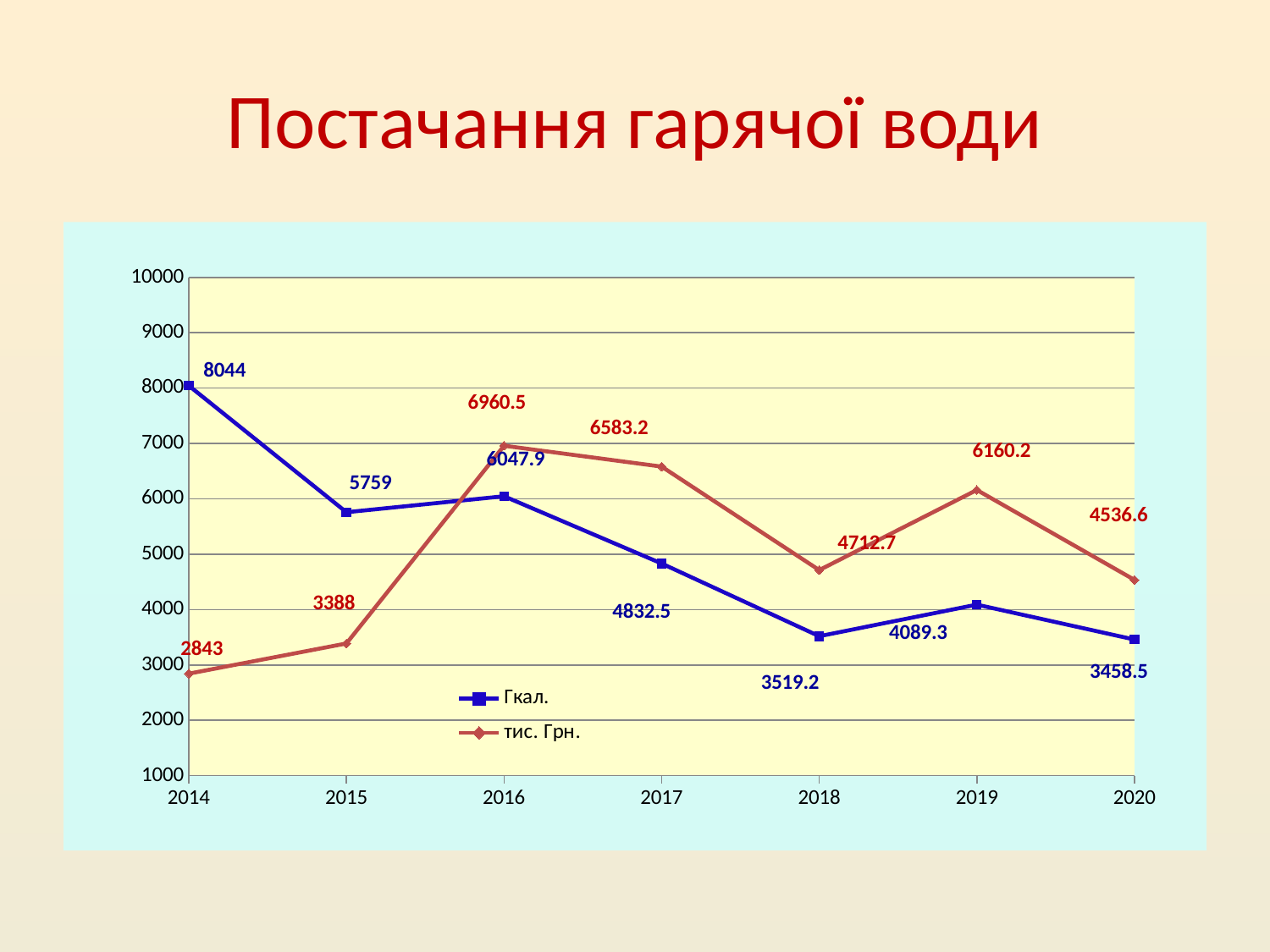
In which year is the Гкал. series at its lowest? 2020 What is the difference between the Гкал. values for 2014 and 2015? 2285 How many series does the legend list? 2 Which series has the larger value in 2019, Гкал. or тис. Грн.? тис. Грн. What is the value of the Гкал. series in 2020? 3458.5 How many years are shown on the x axis? 7 What kind of chart is shown on the slide? line chart What is the value of the Гкал. series in 2014? 8044 What is the value of the тис. Грн. series in 2016? 6960.5 In which year is the тис. Грн. series at its highest? 2016 In which year is the тис. Грн. series at its lowest? 2014 What is the difference between the тис. Грн. and Гкал. values in 2016? 912.6